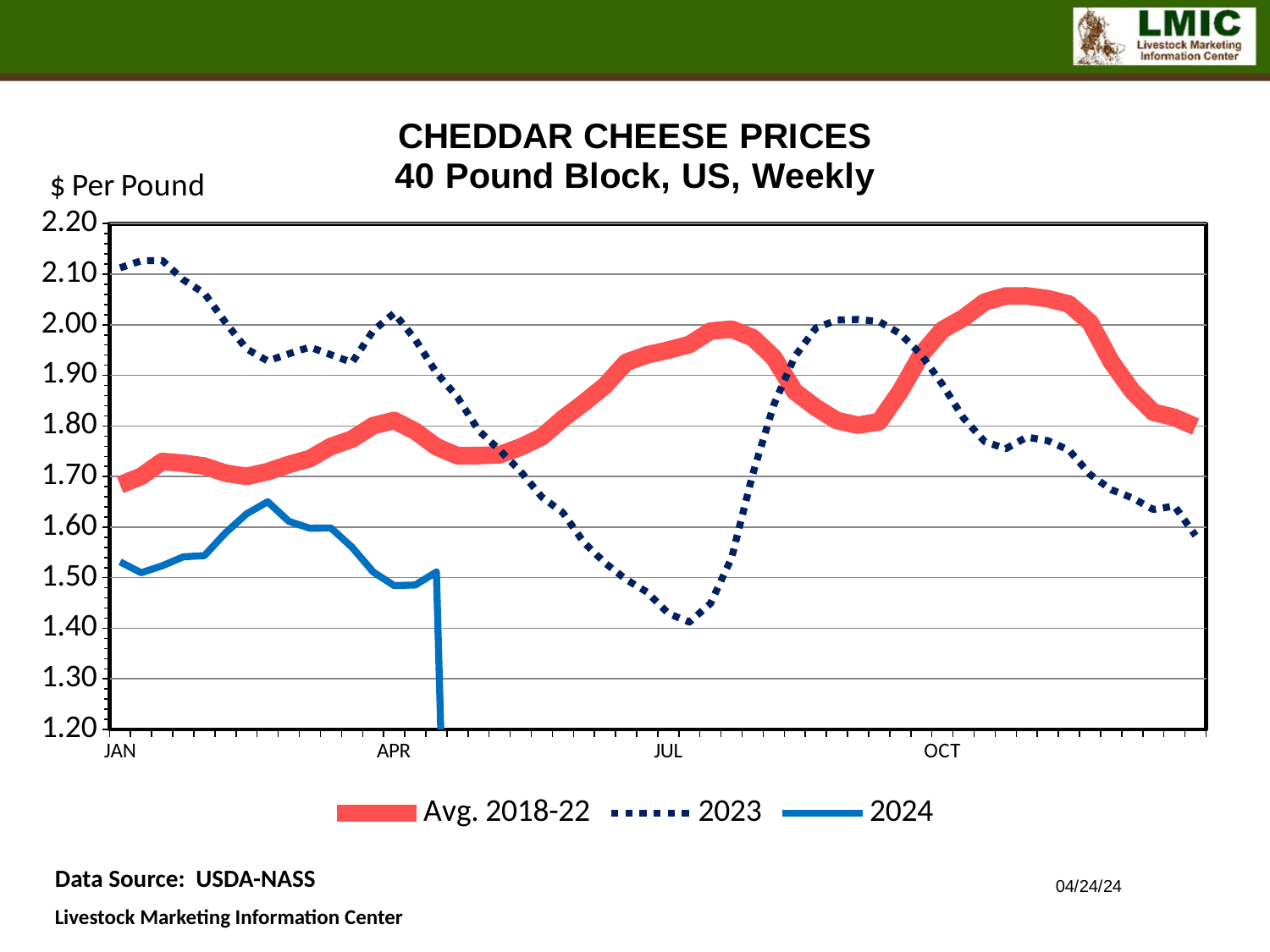
Does the 2023 line rise or fall from JAN to JUL? fall Is the value of the 2023 line in JAN greater or less than 2.00? greater What kind of chart is shown on the slide? line chart How many series does the legend list? 3 What are the three series listed in the legend? Avg. 2018-22, 2023, 2024 How many month labels are shown on the x axis? 4 In JAN, which line is higher, 2023 or 2024? 2023 Is the value of the 2023 line at the end of the year (December) greater or less than 1.70? less What unit is shown on the y-axis label? $ Per Pound Is the value of the Avg. 2018-22 line in JAN greater or less than 1.80? less In JUL, which line is higher, Avg. 2018-22 or 2023? Avg. 2018-22